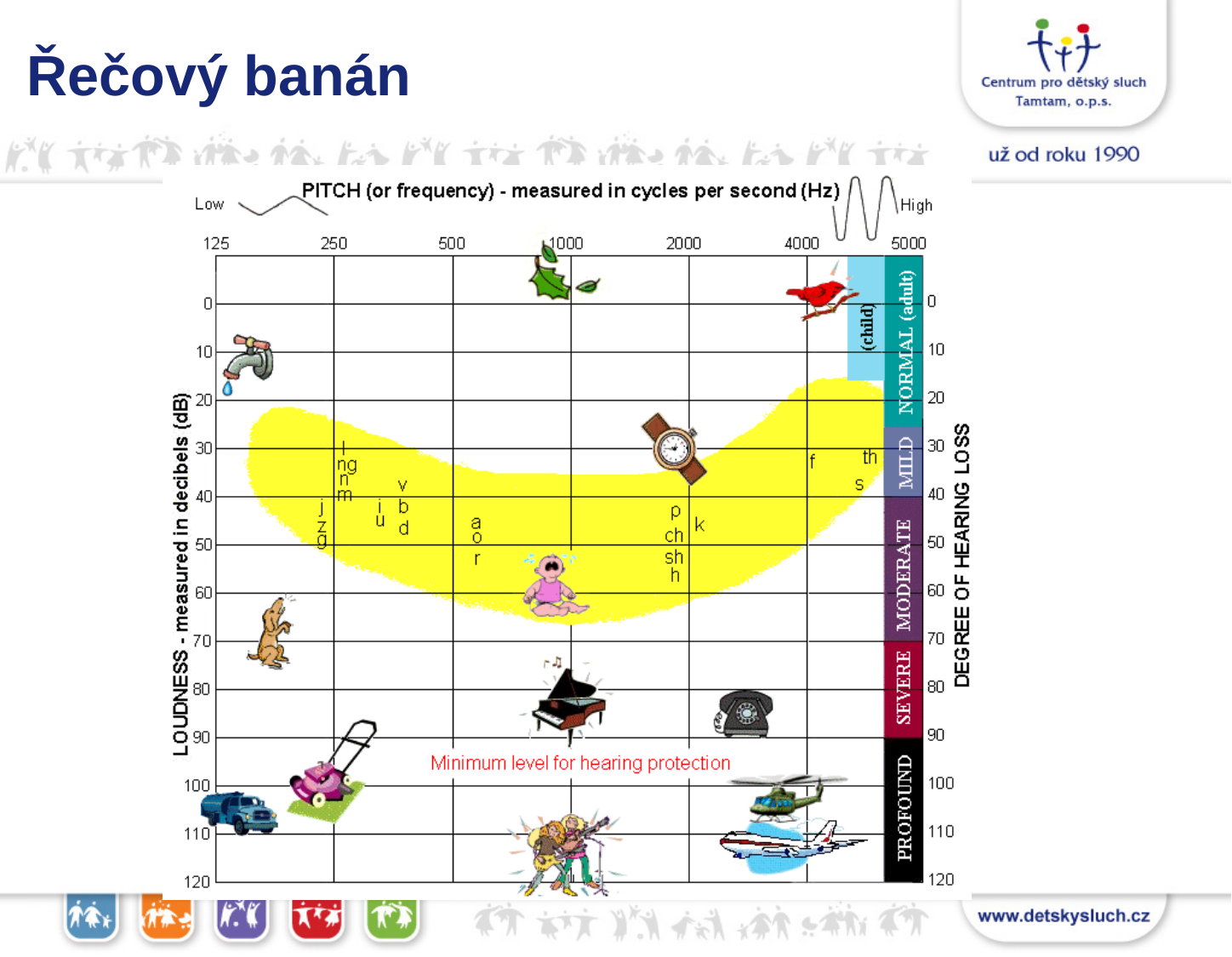
What is the label of the left vertical axis of the chart? LOUDNESS - measured in decibels (dB) What is the label of the horizontal (top) axis of the chart? PITCH (or frequency) - measured in cycles per second (Hz) What is the lowest frequency value printed on the top axis of the chart? 125 How many frequency tick values are printed along the top axis of the chart? 7 What is the highest frequency value printed on the top axis of the chart? 5000 Which degree of hearing loss category covers the 100 dB level on the chart? PROFOUND How many degree-of-hearing-loss categories are listed on the right side of the chart? 5 Which speech sounds are printed in the chart near the 4000 Hz column? f, th, s What does the red text printed near the 90 dB line on the chart say? Minimum level for hearing protection Which degree of hearing loss category covers the 50 dB level on the chart? MODERATE What is the largest decibel value printed on the left axis of the chart? 120 Which degree of hearing loss category covers the 80 dB level on the chart? SEVERE